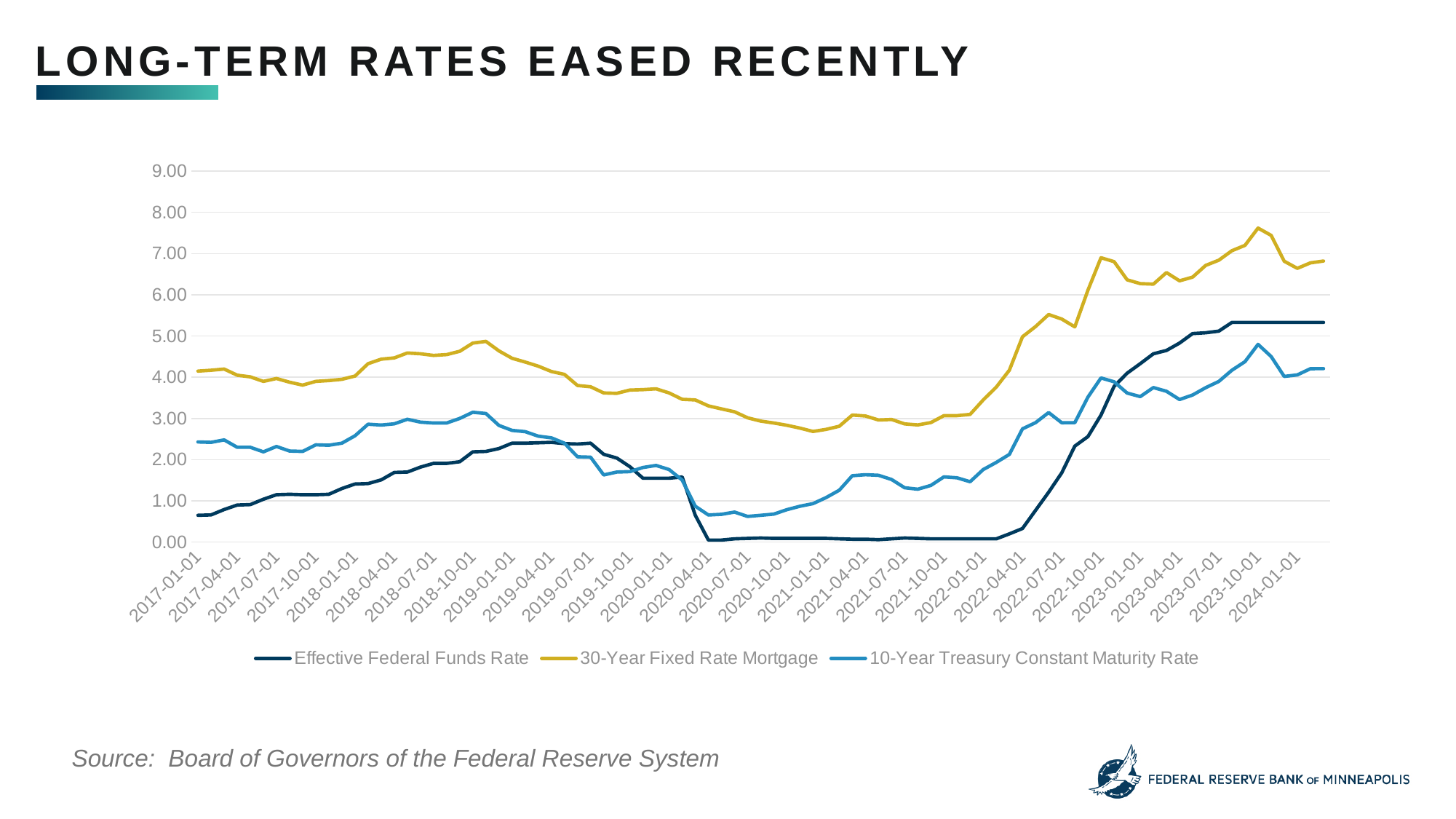
At 2024-01-01, which is higher: the Effective Federal Funds Rate or the 10-Year Treasury Constant Maturity Rate? Effective Federal Funds Rate Is the value of the 30-Year Fixed Rate Mortgage at 2021-01-01 greater or less than 3.00? less What type of chart is shown on the slide? Line chart Which series reaches the highest value anywhere on the chart? 30-Year Fixed Rate Mortgage How many series does the legend list? 3 Which series is drawn in yellow? 30-Year Fixed Rate Mortgage Is the value of the 30-Year Fixed Rate Mortgage at 2023-10-01 greater or less than 7.00? greater What is the title of the slide's chart? LONG-TERM RATES EASED RECENTLY At 2020-10-01, which is higher: the Effective Federal Funds Rate or the 10-Year Treasury Constant Maturity Rate? 10-Year Treasury Constant Maturity Rate Is the value of the Effective Federal Funds Rate at 2020-07-01 greater or less than 1.00? less Does the Effective Federal Funds Rate rise or fall between 2022-01-01 and 2023-07-01? Rise